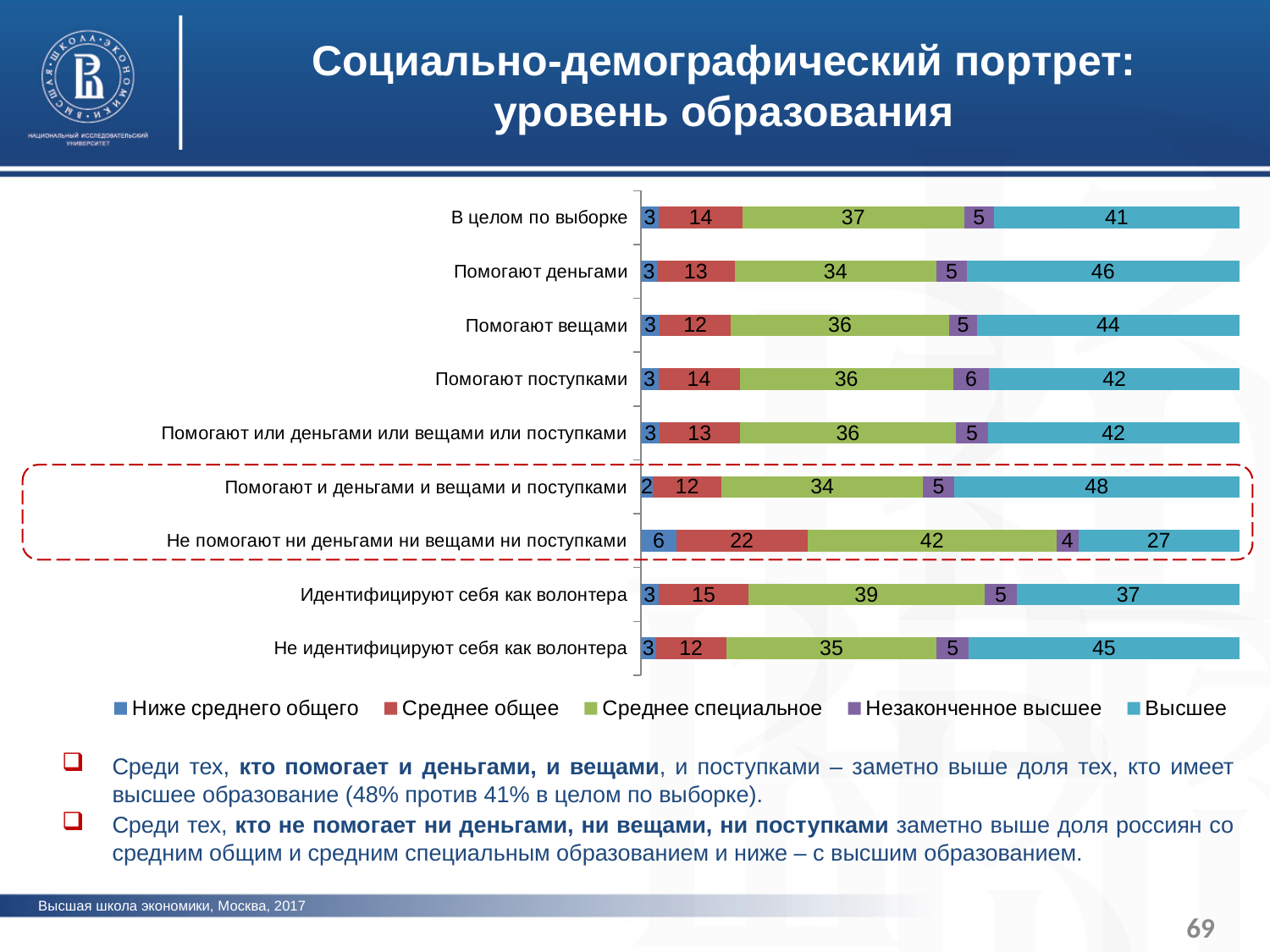
What is the value of the Незаконченное высшее series for the category 'Помогают поступками'? 6 What is the value of the Среднее общее series for the category 'Не помогают ни деньгами ни вещами ни поступками'? 22 What is the value of the Высшее series for the category 'Помогают и деньгами и вещами и поступками'? 48 Which category has the lowest value in the Высшее series? Не помогают ни деньгами ни вещами ни поступками How many series does the legend list? 5 Which category has the highest value in the Высшее series? Помогают и деньгами и вещами и поступками In the Среднее специальное series, which is larger: 'Идентифицируют себя как волонтера' or 'Не идентифицируют себя как волонтера'? Идентифицируют себя как волонтера Which category has the highest value in the Среднее специальное series? Не помогают ни деньгами ни вещами ни поступками What is the difference in the Высшее series between 'Помогают и деньгами и вещами и поступками' and 'В целом по выборке'? 7 What kind of chart is shown on the slide? Stacked bar chart What is the difference in the Среднее общее series between 'Не помогают ни деньгами ни вещами ни поступками' and 'В целом по выборке'? 8 How many categories are shown on the chart? 9